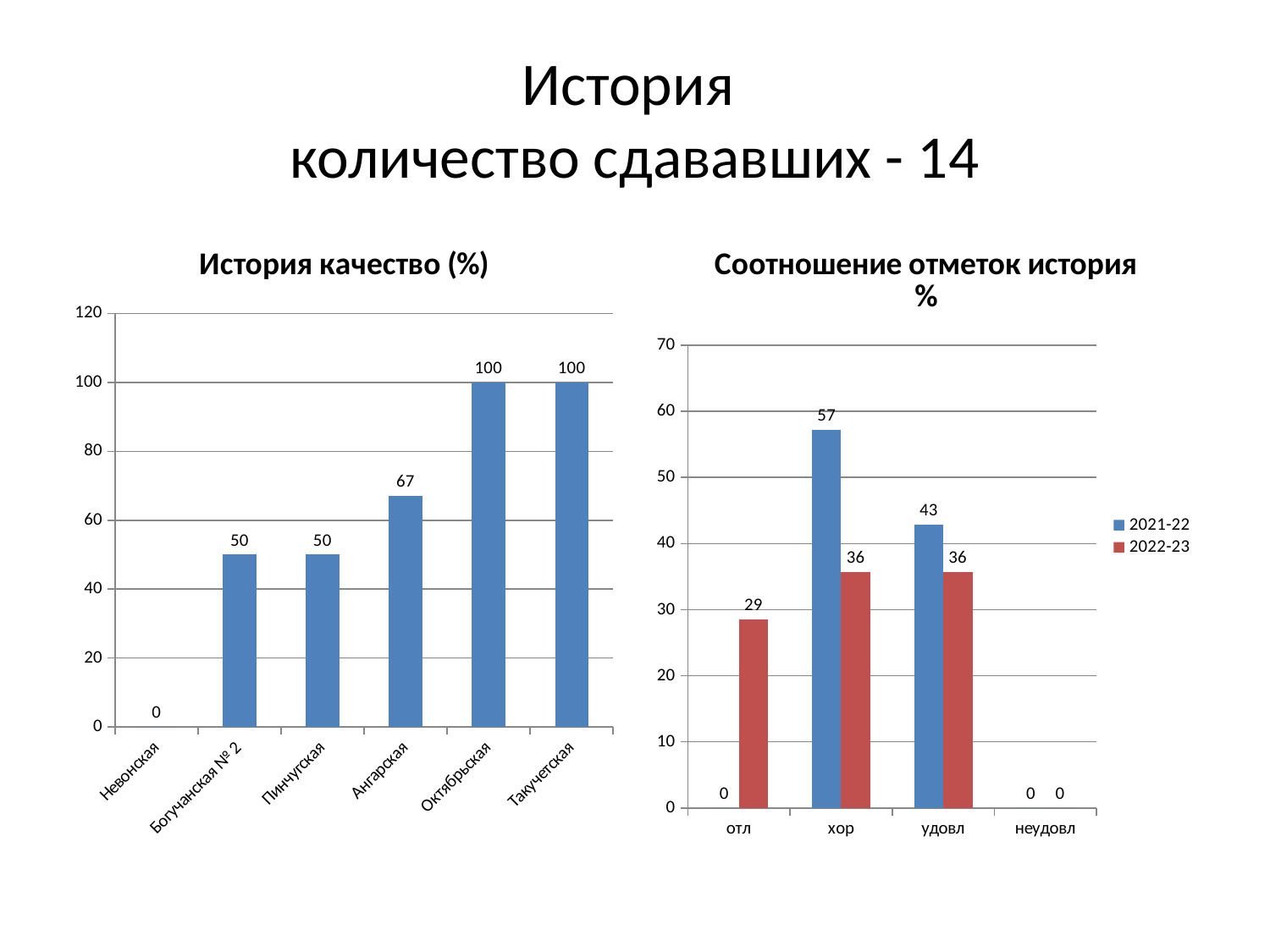
In the chart titled 'История качество (%)', what is the value for Невонская? 0 In the chart titled 'История качество (%)', what kind of chart is it? bar chart In the chart titled 'Соотношение отметок история %', which is larger for удовл: the 2021-22 value or the 2022-23 value? 2021-22 In the chart titled 'История качество (%)', which category has the lowest value? Невонская In the chart titled 'История качество (%)', what is the value for Ангарская? 67 In the chart titled 'Соотношение отметок история %', what is the value for хор in the 2021-22 series? 57 In the chart titled 'Соотношение отметок история %', which category has the highest value in the 2021-22 series? хор In the chart titled 'Соотношение отметок история %', what is the value for отл in the 2022-23 series? 29 In the chart titled 'История качество (%)', what is the difference between the values for Октябрьская and Ангарская? 33 In the chart titled 'Соотношение отметок история %', how many series does the legend list? 2 In the chart titled 'Соотношение отметок история %', what is the difference between the 2021-22 and 2022-23 values for хор? 21 In the chart titled 'История качество (%)', how many categories are shown on the x axis? 6